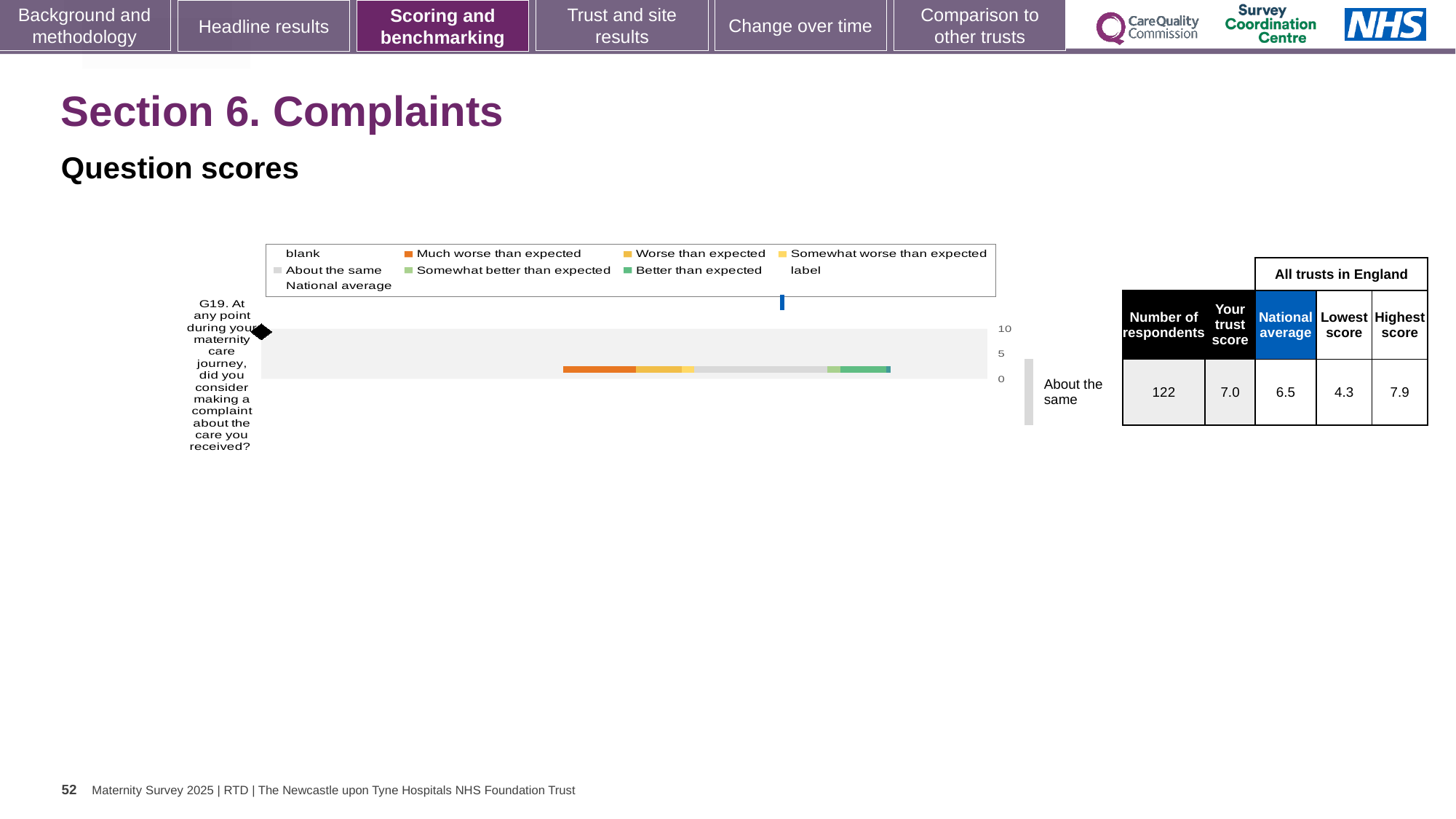
What benchmark category is shown for question G19? About the same What is the difference between the highest score and the lowest score for question G19? 3.6 What is the highest score among all trusts in England for question G19? 7.9 Which is larger for question G19, the trust score or the national average? the trust score What is the national average score for question G19? 6.5 What colour does the legend use for 'Much worse than expected'? orange What kind of chart is used to show the question score for G19? bar chart How many respondents answered question G19? 122 What is the trust's score for question G19? 7.0 According to the legend, what does the blue vertical line on the chart represent? National average What is the lowest score among all trusts in England for question G19? 4.3 How many survey questions are plotted on the chart? 1